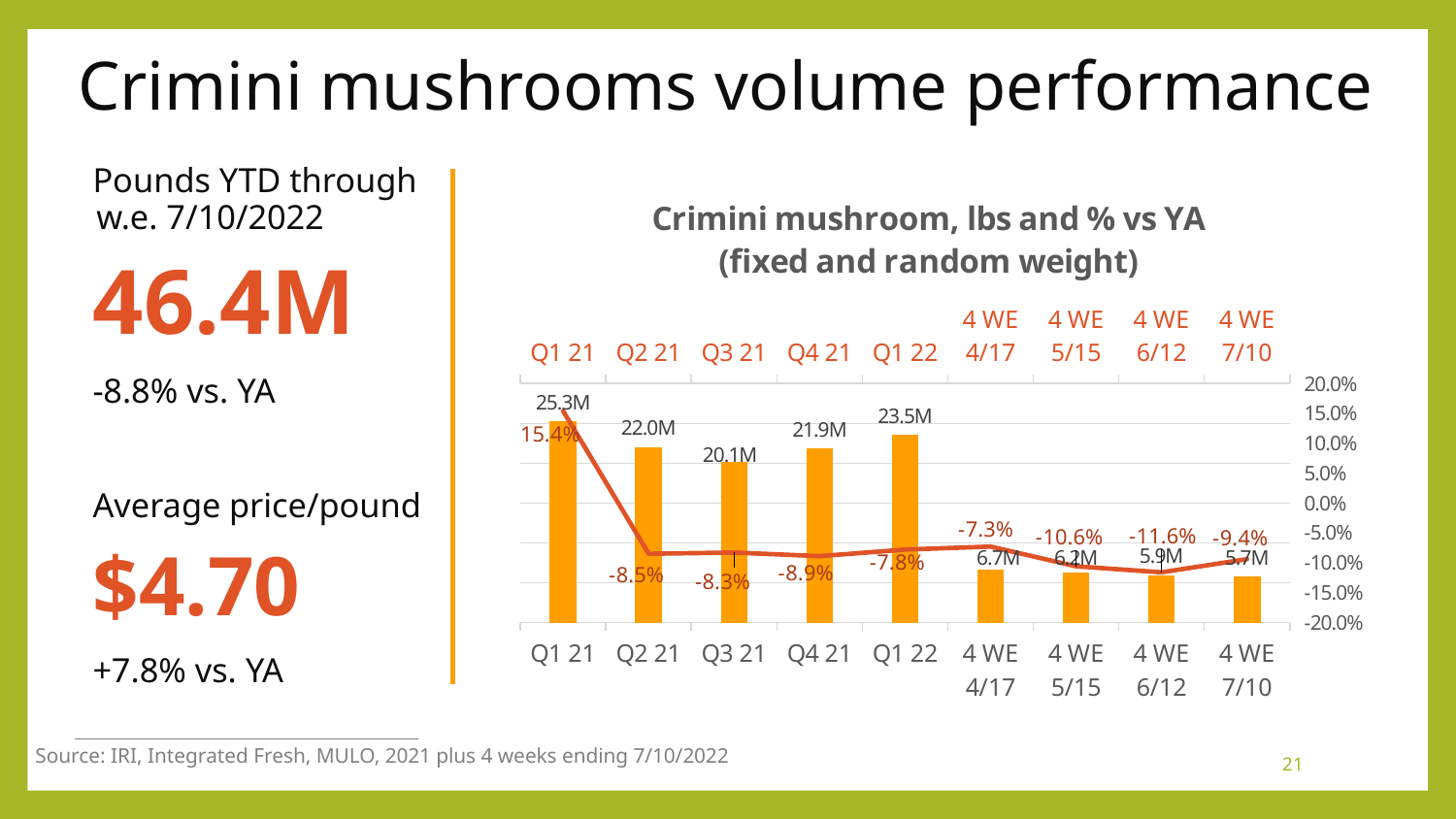
What is the difference in pounds between Q1 22 and Q4 21? 1.6M What is the % vs YA value for Q1 22? -7.8% Which period has the lowest % vs YA value? 4 WE 6/12 Is the % vs YA value for Q1 21 greater or less than 10.0%? greater What is the volume in pounds for the 4 WE 7/10 period? 5.7M What is the volume in pounds for Q1 21? 25.3M Which has the larger volume in pounds, Q2 21 or Q3 21? Q2 21 Which period has the highest volume in pounds? Q1 21 How many periods are shown on the x axis of the chart? 9 What is the % vs YA value for the 4 WE 6/12 period? -11.6% What is the title of the chart? Crimini mushroom, lbs and % vs YA (fixed and random weight) What kind of chart is shown on the slide? Bar chart with a line